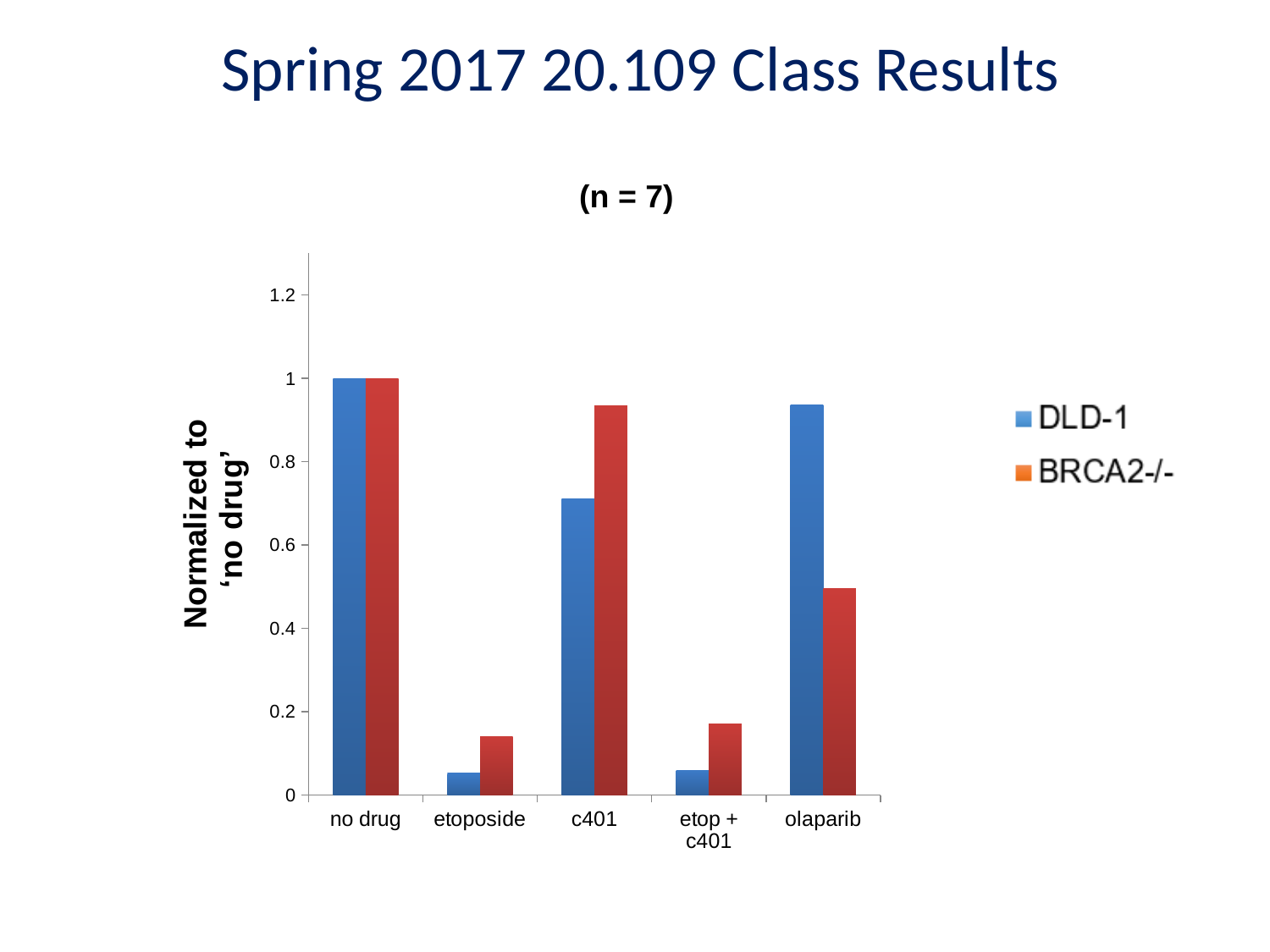
Is the value for DLD-1 in the etoposide category greater or less than 0.2? less How many categories are shown on the x axis? 5 What is the value for DLD-1 in the 'no drug' category? 1 In the c401 category, which series has the larger value, DLD-1 or BRCA2-/-? BRCA2-/- In the olaparib category, which series has the larger value, DLD-1 or BRCA2-/-? DLD-1 Which category has the highest value for the DLD-1 series? no drug Is the value for BRCA2-/- in the olaparib category greater or less than 0.4? greater How many series does the legend list? 2 What is the value for BRCA2-/- in the 'no drug' category? 1 What kind of chart is shown on the slide? bar chart What is the title of the y axis? Normalized to 'no drug' Is the value for DLD-1 in the c401 category greater or less than 0.6? greater